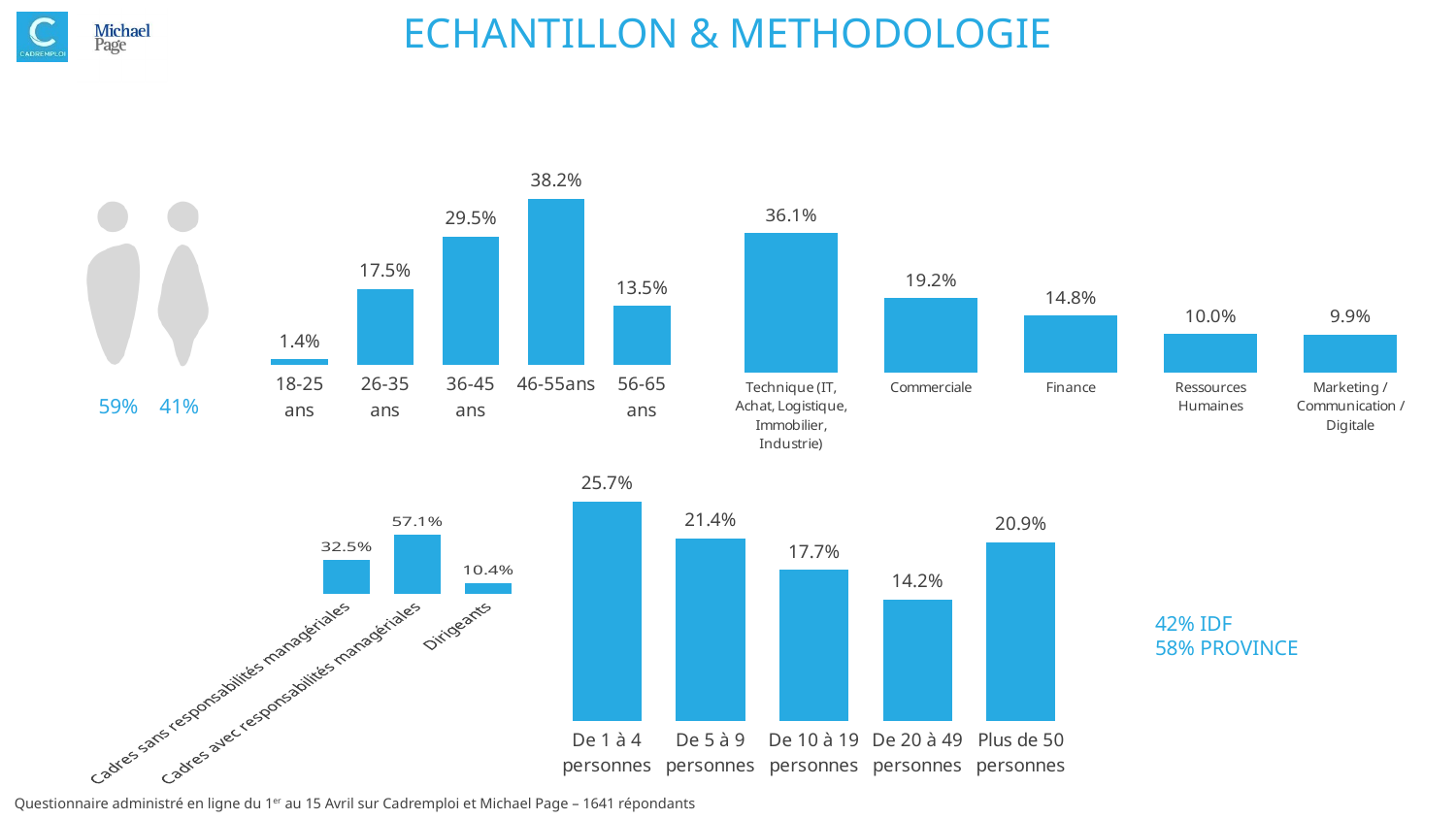
In the bottom-center bar chart of team sizes, what is the value for De 20 à 49 personnes? 14.2% In the top-right bar chart of job functions, which category has the highest value? Technique (IT, Achat, Logistique, Immobilier, Industrie) In the top-right bar chart of job functions, which is larger: Finance or Ressources Humaines? Finance In the age-group bar chart at the top of the slide, which age group has the lowest value? 18-25 ans In the top-right bar chart of job functions, what is the value for Commerciale? 19.2% In the bottom-center bar chart of team sizes, what is the difference between the values for De 1 à 4 personnes and Plus de 50 personnes? 4.8% In the age-group bar chart at the top of the slide, what is the difference between the values for 36-45 ans and 26-35 ans? 12.0% In the age-group bar chart at the top of the slide, how many age groups are shown? 5 In the bottom-left bar chart of managerial responsibility, what is the value for Dirigeants? 10.4% In the bottom-left bar chart of managerial responsibility, which category has the highest value? Cadres avec responsabilités managériales In the age-group bar chart at the top of the slide, what is the value for 46-55 ans? 38.2% What type of chart is used for the team-size data at the bottom center of the slide? Bar chart